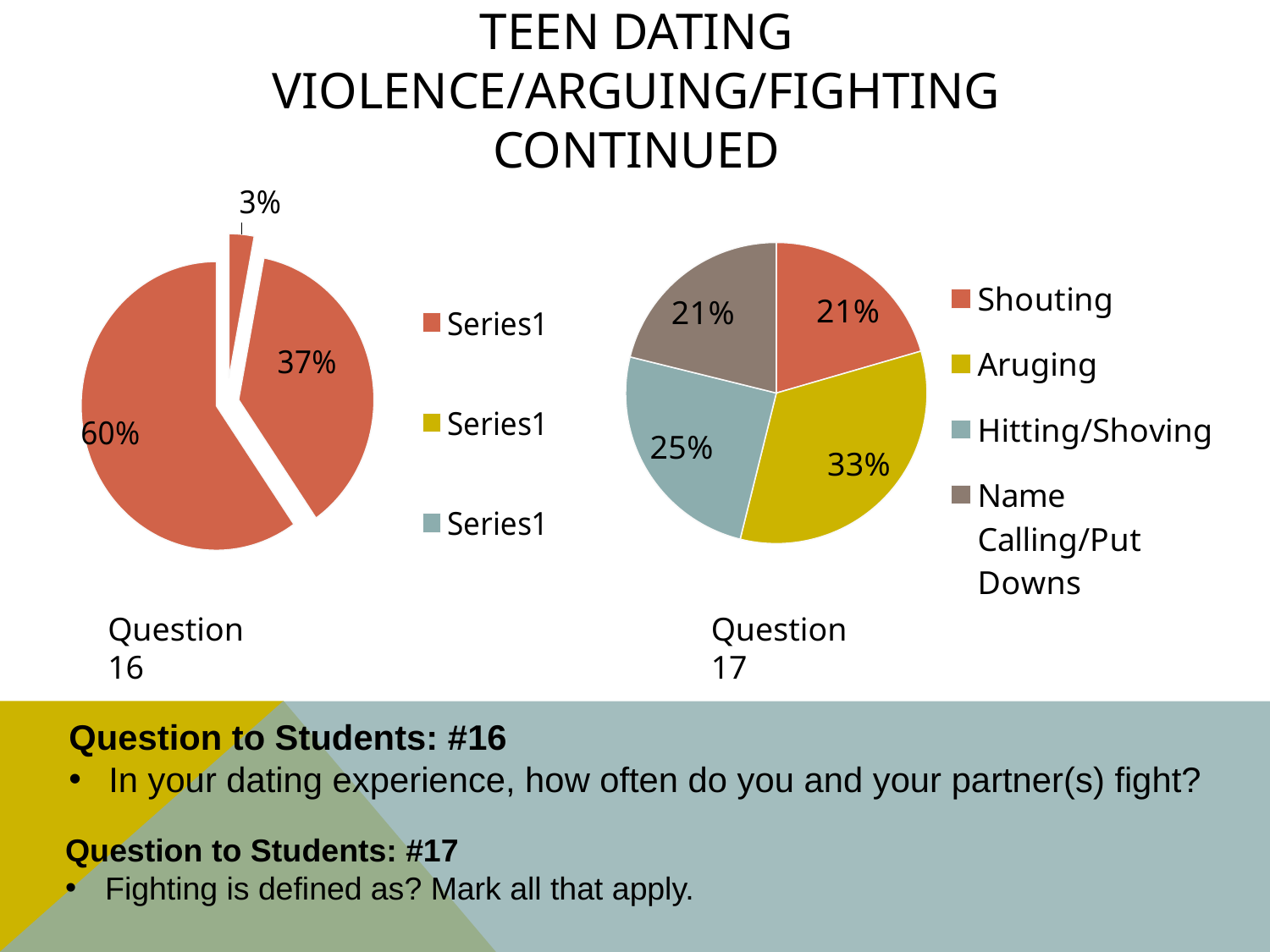
In the Question 17 pie chart, what percentage is shown for Hitting/Shoving? 25% What type of chart is the Question 16 chart? Pie chart In the Question 17 pie chart, which is larger, Hitting/Shoving or Shouting? Hitting/Shoving In the Question 17 pie chart, what percentage is shown for Aruging? 33% In the Question 17 pie chart, what is the difference between the Aruging and Hitting/Shoving percentages? 8% In the Question 16 pie chart, what is the percentage of the smallest slice? 3% In the Question 17 pie chart, which category has the largest slice? Aruging In the Question 17 pie chart, what percentage is shown for Shouting? 21% In the Question 17 pie chart, what colour is the Name Calling/Put Downs slice? Brown How many slices does the Question 16 pie chart have? 3 In the Question 16 pie chart, what is the percentage of the largest slice? 60% How many categories does the legend of the Question 17 pie chart list? 4